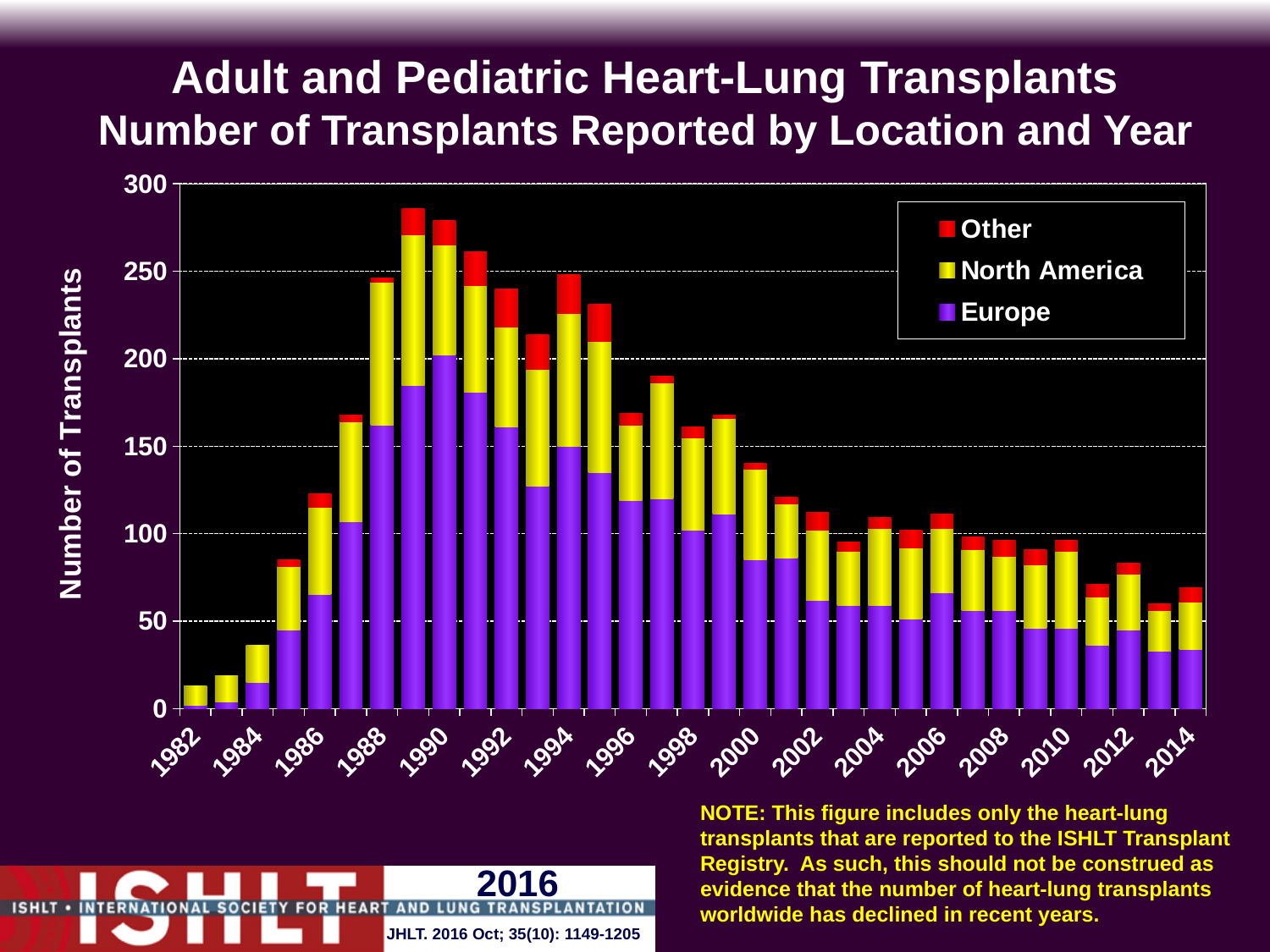
Is the Europe value for 1990 greater or less than 150? greater What kind of chart is shown on the slide? Stacked bar chart Do the total numbers of transplants generally rise or fall from 1990 to 2014? fall Is the total number of transplants in 2000 greater or less than 150? less Which year has a larger total number of transplants, 1986 or 2000? 2000 Is the total number of transplants in 1988 greater or less than 200? greater Which year has the tallest stacked bar (highest total number of transplants)? 1989 Which series is shown in purple in the legend? Europe Which year has the shortest stacked bar (lowest total number of transplants)? 1982 What is the title of the vertical axis? Number of Transplants How many series does the legend list? 3